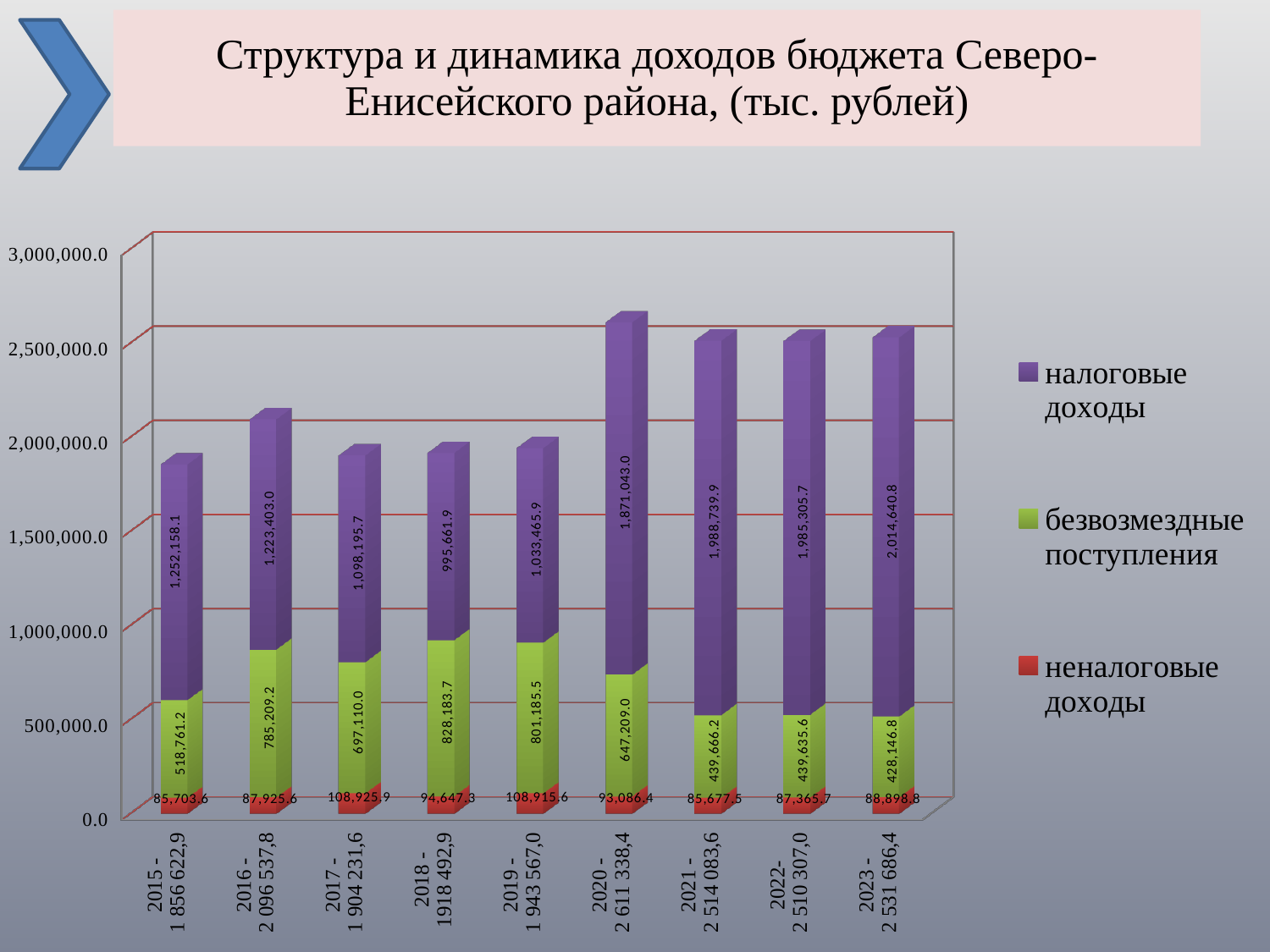
What is the total budget income shown for 2020? 2 611 338,4 How many series does the legend list? 3 What is the difference in налоговые доходы between 2020 and 2019? 837,577.1 What is the value of безвозмездные поступления for 2016? 785,209.2 In which year are налоговые доходы the lowest? 2018 In which year are налоговые доходы the highest? 2023 What is the value of неналоговые доходы for 2023? 88,898.8 In which year are безвозмездные поступления the lowest? 2023 What type of chart is shown on the slide? stacked bar chart How many years (categories) are shown on the x axis? 9 What is the value of налоговые доходы for 2020? 1,871,043.0 Which is larger: безвозмездные поступления in 2018 or in 2019? 2018